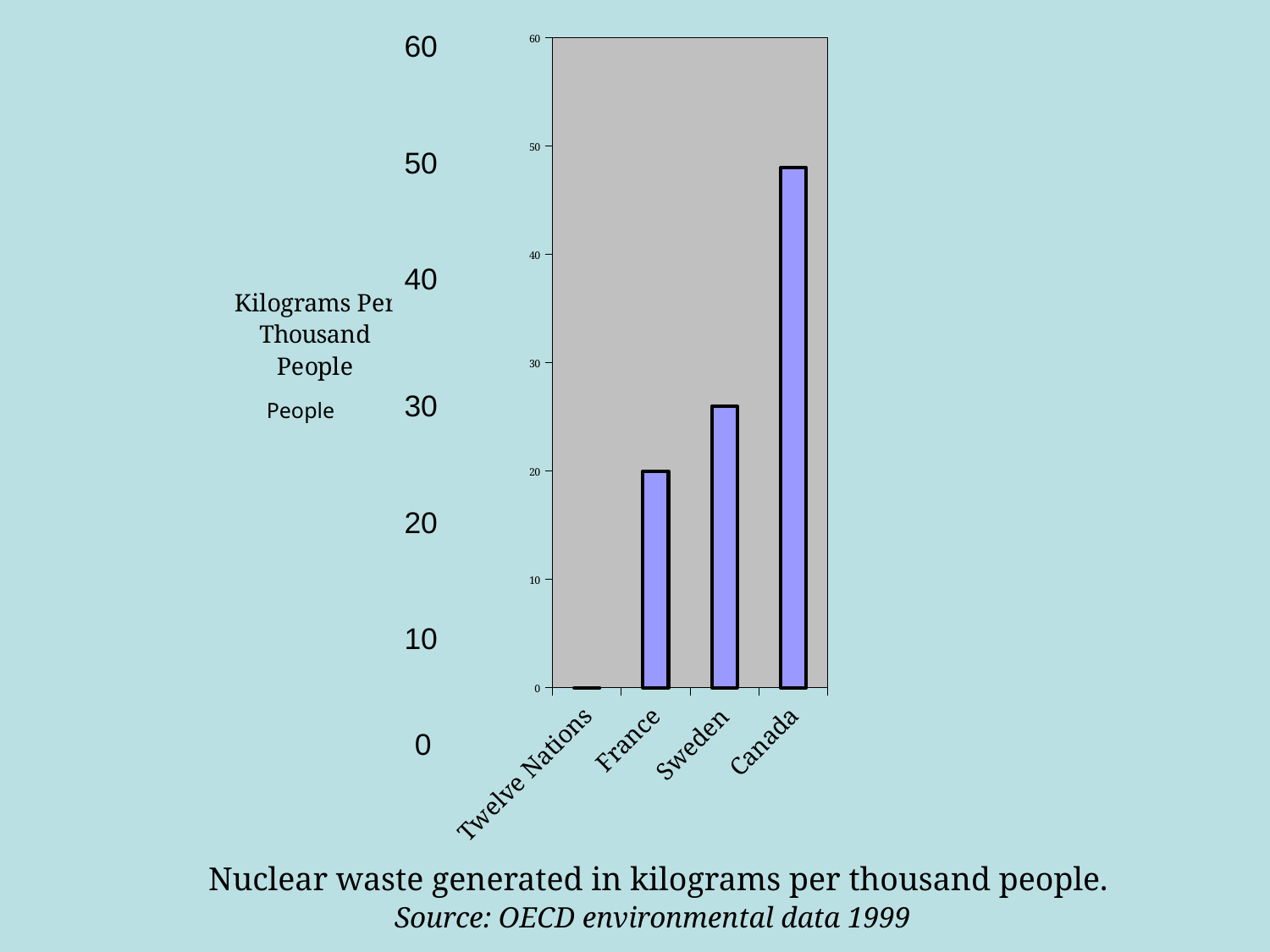
What kind of chart is shown on the slide? bar chart Which category has the lowest value in the chart? Twelve Nations What is the value for France in the chart? 20 Do the bar values rise or fall moving from left to right along the x axis? rise Which has a larger value, Sweden or France? Sweden Which category has the highest value in the chart? Canada Is the value for Canada greater or less than 50? less How many categories are plotted on the x axis of the chart? 4 Is the value for Canada greater or less than 40? greater Is the value for Sweden greater or less than 20? greater What is the source cited below the chart? OECD environmental data 1999